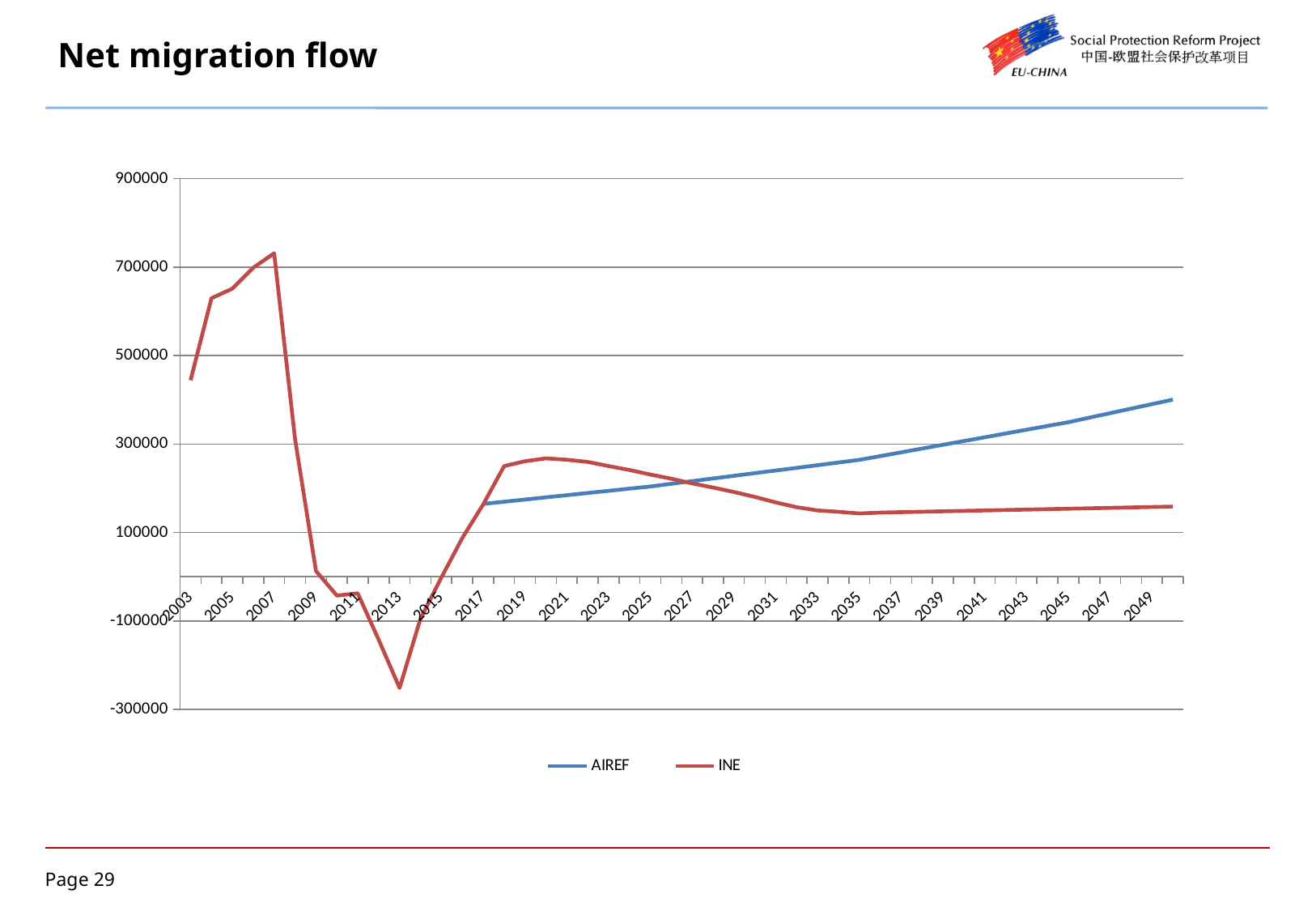
What is the title of the slide's chart? Net migration flow How many series does the legend list? 2 Is the INE value for 2013 greater or less than -100000? less Is the INE value for 2049 greater or less than 300000? less Is the AIREF value for 2049 greater or less than 300000? greater What kind of chart is shown on the slide? line chart In 2049, which series has the larger value, AIREF or INE? AIREF In which year does the INE series reach its lowest value? 2013 Which series is drawn in blue? AIREF In which year does the INE series reach its highest value? 2007 Does the AIREF series rise or fall from 2017 to 2049? rise